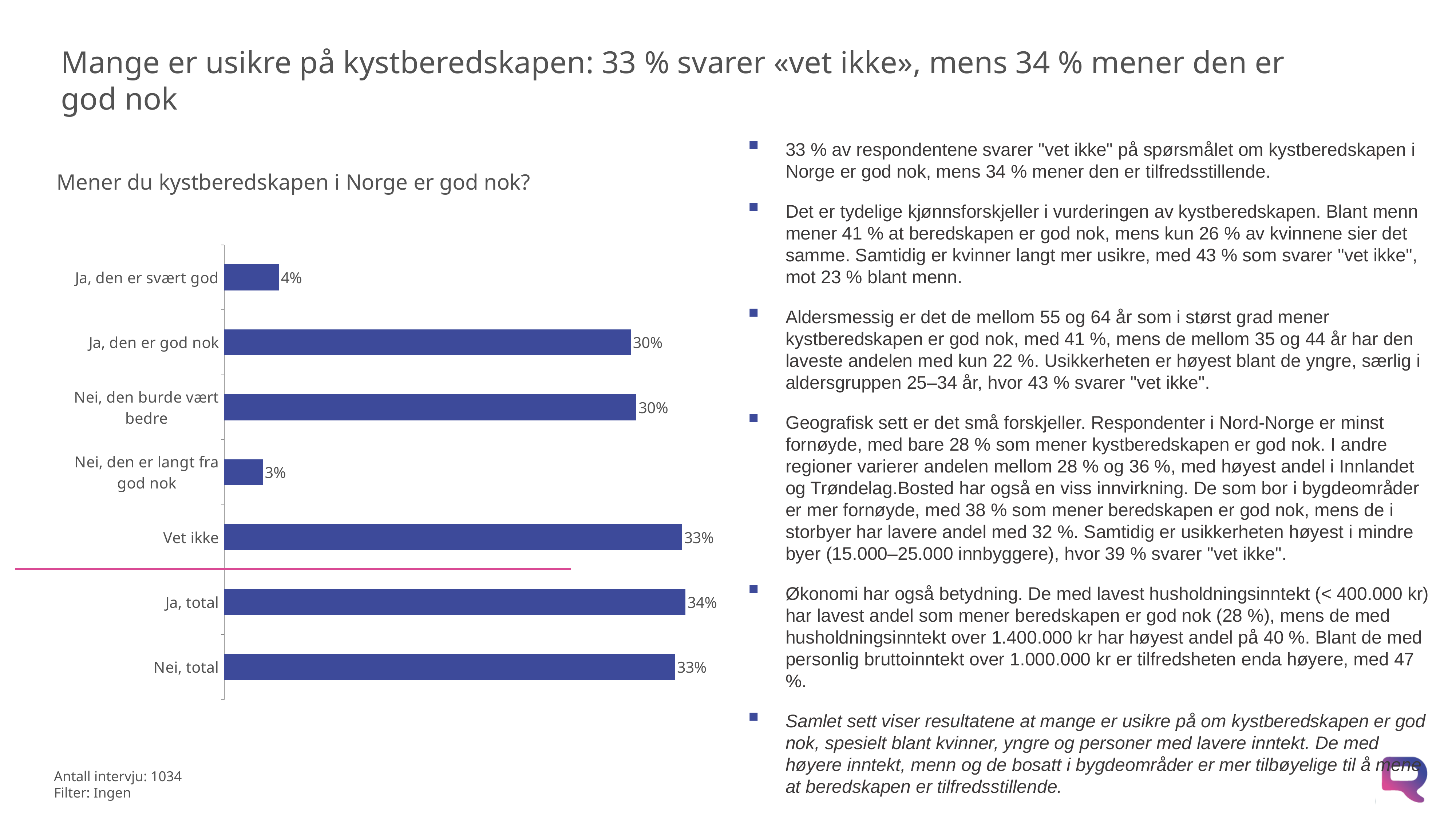
What question is the chart titled with? Mener du kystberedskapen i Norge er god nok? How many categories are shown in the chart? 7 What is the value for "Nei, den burde vært bedre"? 30% What is the difference between "Vet ikke" and "Ja, den er svært god"? 29 percentage points What is the value for "Ja, den er svært god"? 4% What is the difference between "Ja, total" and "Nei, total"? 1 percentage point What kind of chart is shown on the slide? Bar chart Which category has the lowest value? Nei, den er langt fra god nok Which category has the highest value? Ja, total What is the value for "Ja, total"? 34% Which is larger, "Ja, den er svært god" or "Nei, den er langt fra god nok"? Ja, den er svært god What is the value for "Vet ikke"? 33%